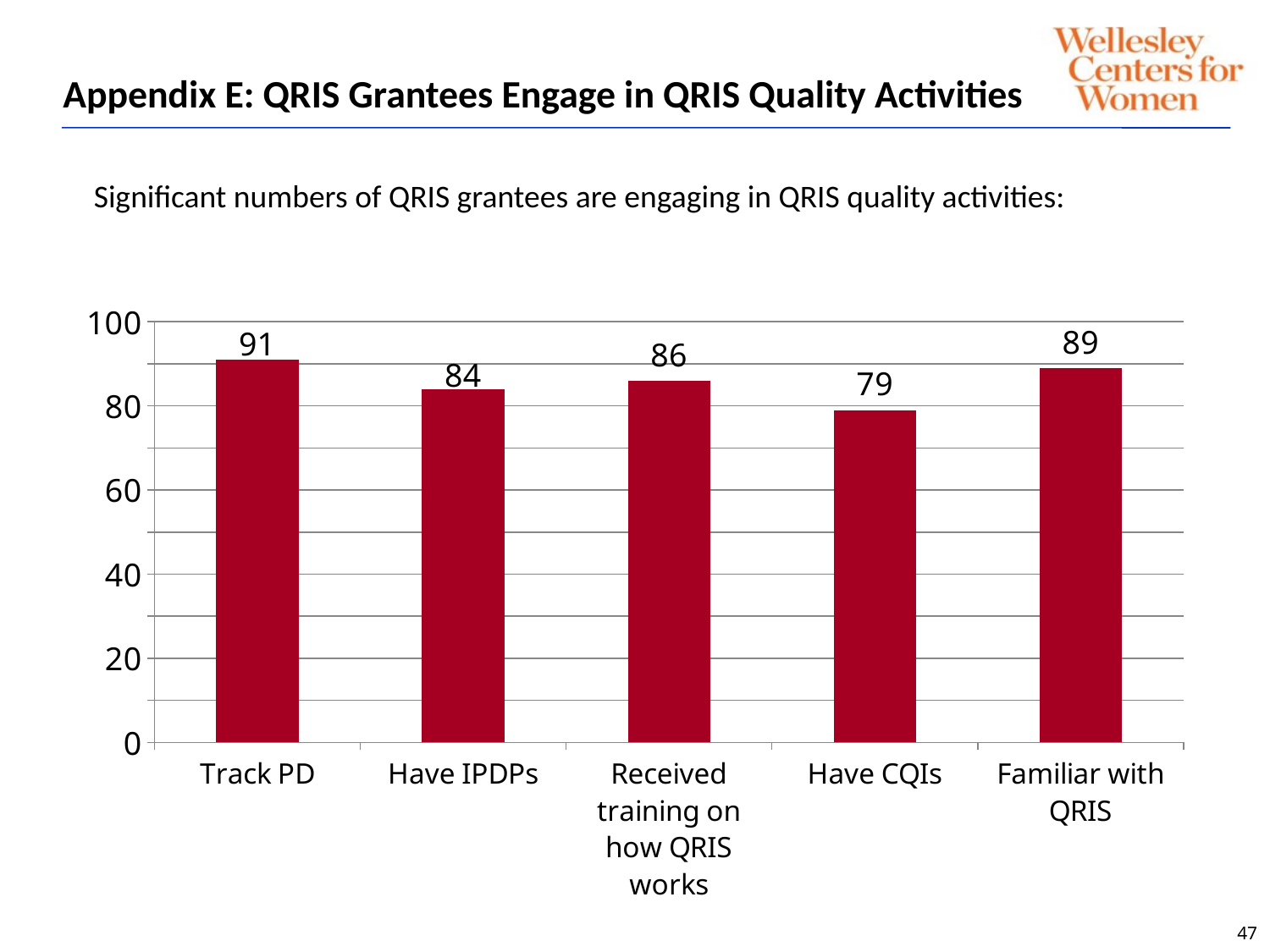
Is the value for Have CQIs greater or less than 80? less Which category has the highest value? Track PD What kind of chart is shown on the slide? bar chart What is the value for Received training on how QRIS works? 86 What is the value for Have CQIs? 79 What is the value for Familiar with QRIS? 89 Which is larger, the value for Have IPDPs or the value for Familiar with QRIS? Familiar with QRIS What is the value for Have IPDPs? 84 What is the value for Track PD? 91 What is the difference between the values for Track PD and Have CQIs? 12 Which category has the lowest value? Have CQIs How many categories are shown on the x axis? 5